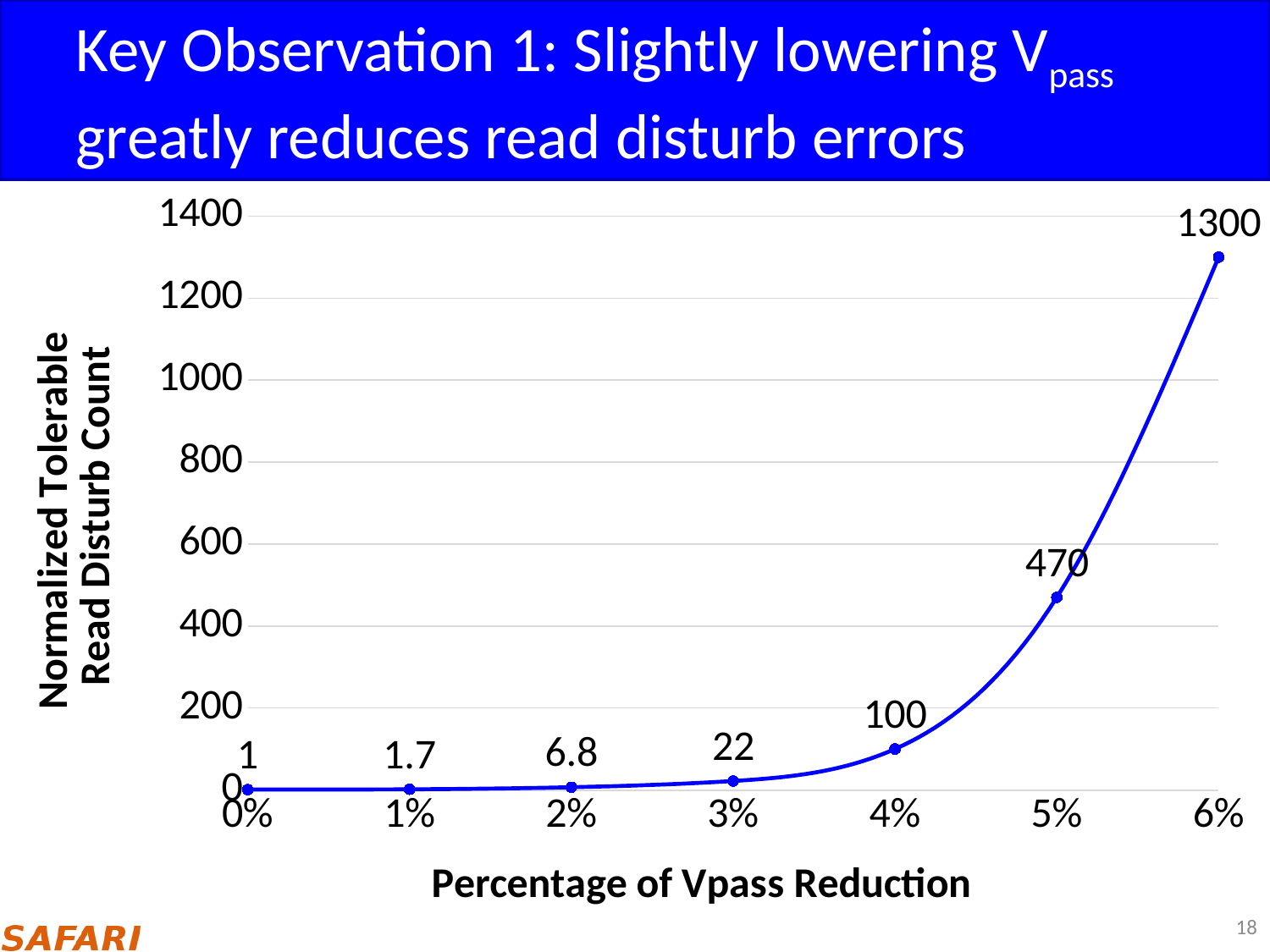
At which percentage of Vpass reduction is the normalized tolerable read disturb count highest? 6% What is the normalized tolerable read disturb count at 1% Vpass reduction? 1.7 What is the normalized tolerable read disturb count at 4% Vpass reduction? 100 At which percentage of Vpass reduction is the normalized tolerable read disturb count lowest? 0% Which has a larger normalized tolerable read disturb count: 3% or 5% Vpass reduction? 5% Does the normalized tolerable read disturb count rise or fall as the percentage of Vpass reduction increases? rise Is the value at 5% Vpass reduction greater or less than 400? greater What is the normalized tolerable read disturb count at 2% Vpass reduction? 6.8 What is the difference between the normalized tolerable read disturb count at 6% and at 5% Vpass reduction? 830 What is the normalized tolerable read disturb count at 6% Vpass reduction? 1300 What kind of chart is shown on the slide? line chart How many data points are plotted on the chart? 7